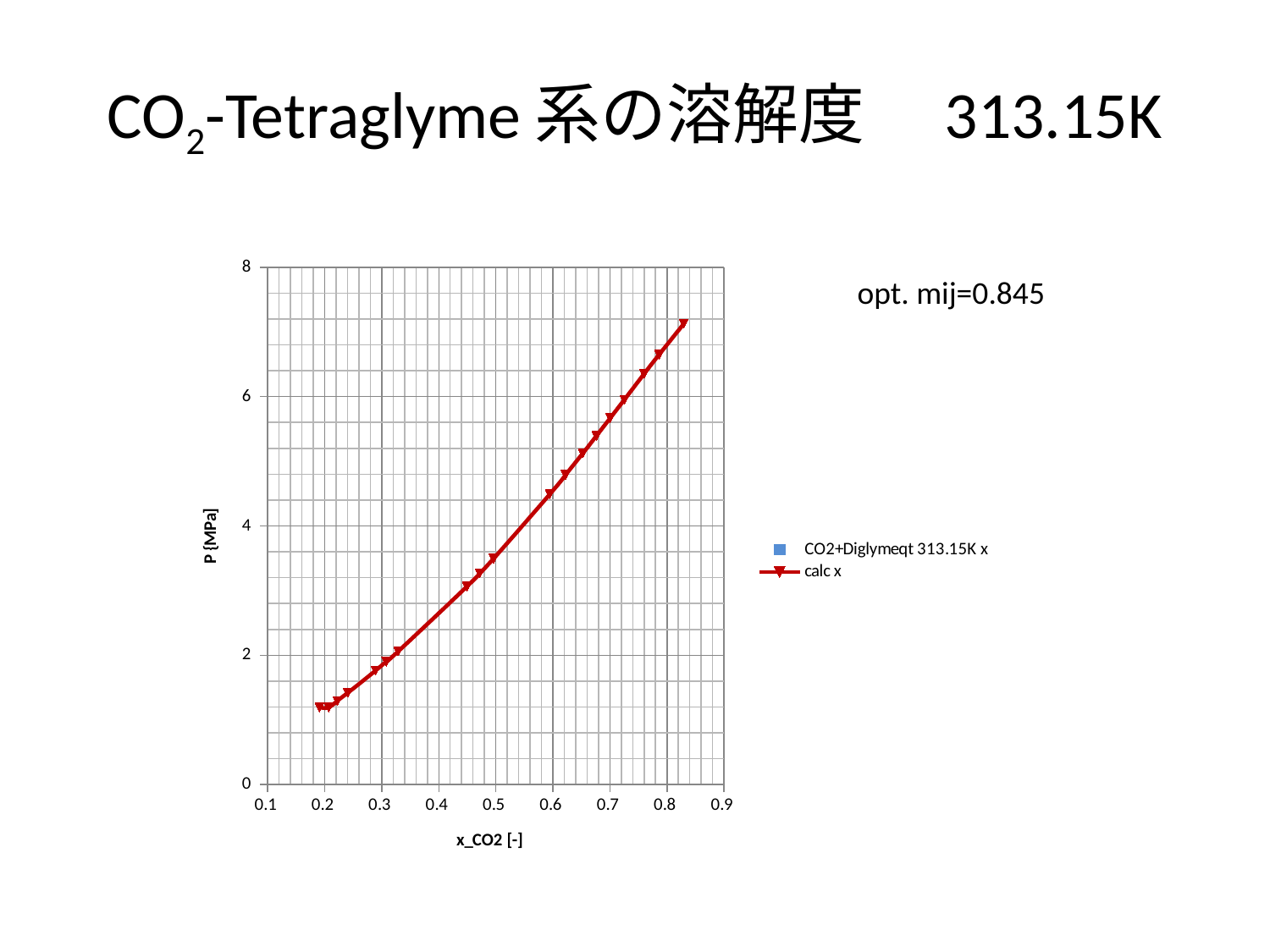
What is the maximum value shown on the y axis of the chart? 8 Is the value of P for the calc x series at x_CO2 = 0.2 greater or less than 2? less How many series does the chart legend list? 2 Does the pressure P rise or fall as x_CO2 increases along the x axis? rise Which is larger for the calc x series: P at x_CO2 = 0.4 or P at x_CO2 = 0.7? P at x_CO2 = 0.7 Is the value of P for the calc x series at x_CO2 = 0.3 greater or less than 2? less What kind of chart is shown on the slide? line chart Is the value of P for the calc x series at x_CO2 = 0.6 greater or less than 4? greater What is the label of the x axis of the chart? x_CO2 [-] What is the label of the y axis of the chart? P [MPa]